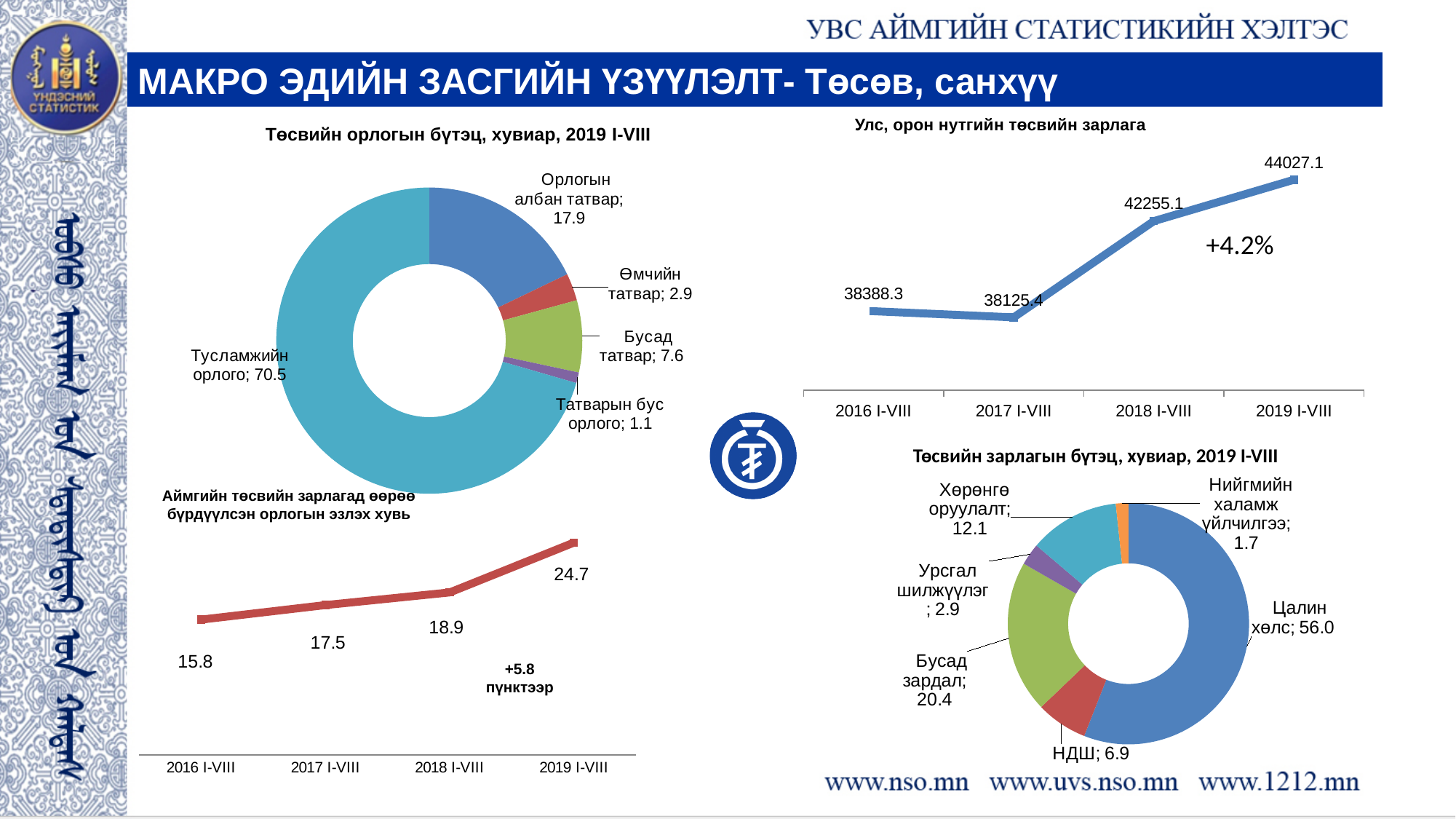
In the chart titled 'Аймгийн төсвийн зарлагад өөрөө бүрдүүлсэн орлогын эзлэх хувь', what is the value for 2017 I-VIII? 17.5 In the chart titled 'Аймгийн төсвийн зарлагад өөрөө бүрдүүлсэн орлогын эзлэх хувь', do the values rise or fall from 2016 I-VIII to 2019 I-VIII? rise What kind of chart is the one titled 'Улс, орон нутгийн төсвийн зарлага'? line chart In the chart titled 'Төсвийн орлогын бүтэц, хувиар, 2019 I-VIII', what is the value for Тусламжийн орлого? 70.5 In the chart titled 'Төсвийн зарлагын бүтэц, хувиар, 2019 I-VIII', which is larger, Хөрөнгө оруулалт or НДШ? Хөрөнгө оруулалт In the chart titled 'Улс, орон нутгийн төсвийн зарлага', what is the value for 2019 I-VIII? 44027.1 In the chart titled 'Улс, орон нутгийн төсвийн зарлага', what is the difference between 2019 I-VIII and 2018 I-VIII? 1772.0 In the chart titled 'Төсвийн орлогын бүтэц, хувиар, 2019 I-VIII', how many slices are there? 5 In the chart titled 'Төсвийн орлогын бүтэц, хувиар, 2019 I-VIII', what is the difference between Орлогын албан татвар and Бусад татвар? 10.3 In the chart titled 'Төсвийн орлогын бүтэц, хувиар, 2019 I-VIII', which category has the smallest slice? Татварын бус орлого In the chart titled 'Төсвийн зарлагын бүтэц, хувиар, 2019 I-VIII', what is the value for Бусад зардал? 20.4 In the chart titled 'Улс, орон нутгийн төсвийн зарлага', which period has the lowest value? 2017 I-VIII